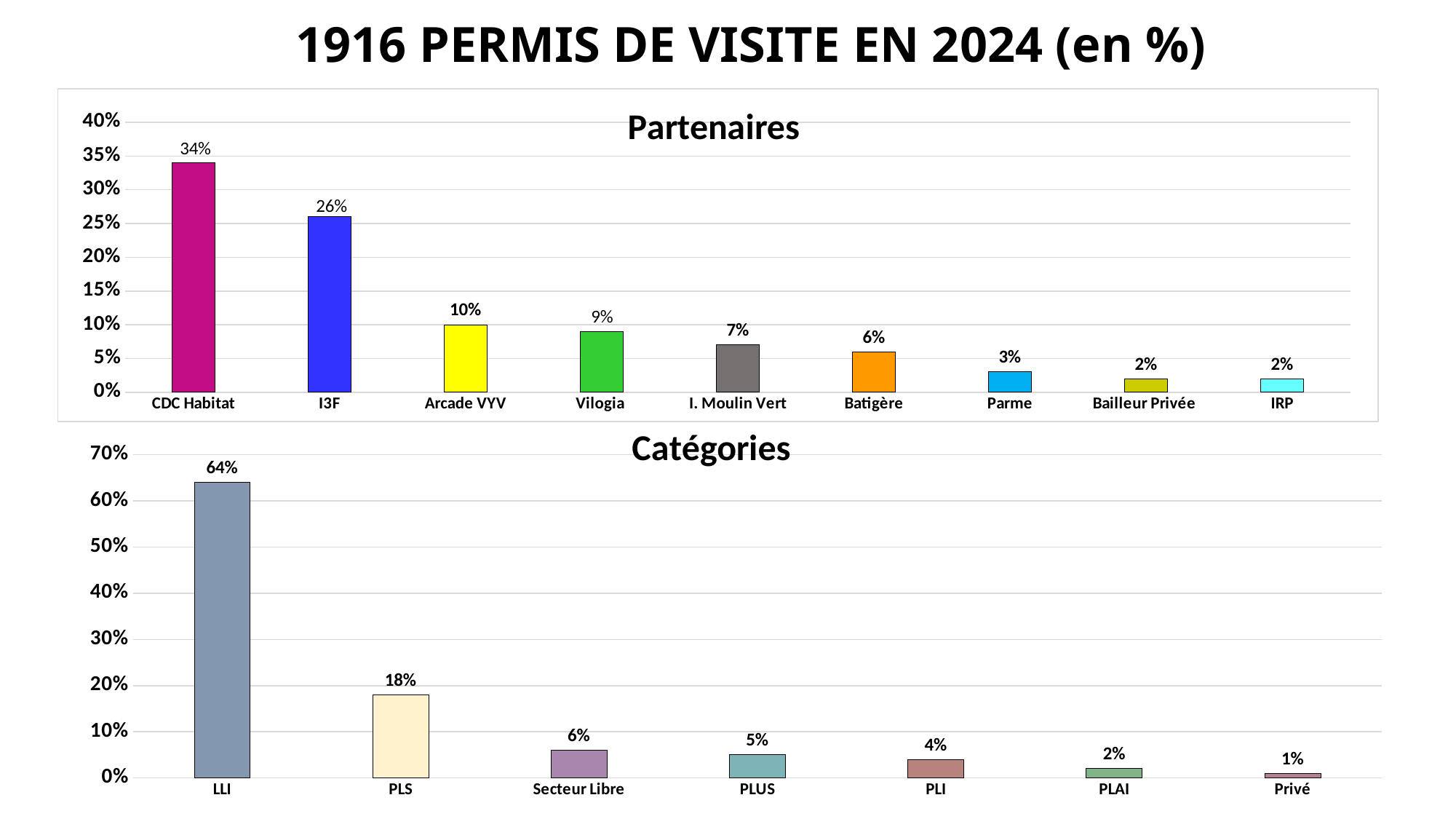
In the Partenaires chart, what is the difference between CDC Habitat and I3F? 8% In the Catégories chart, what is the value for PLS? 18% In the Partenaires chart, which partner has the highest value? CDC Habitat What is the main title of the slide? 1916 PERMIS DE VISITE EN 2024 (en %) In the Catégories chart, which category has the lowest value? Privé What kind of chart is the Catégories chart? Bar chart In the Partenaires chart, how many partners are shown? 9 In the Partenaires chart, what is the value for Vilogia? 9% In the Catégories chart, how many categories are shown? 7 In the Partenaires chart, what is the value for CDC Habitat? 34% In the Partenaires chart, which is larger, Arcade VYV or Batigère? Arcade VYV In the Catégories chart, what is the difference between LLI and PLS? 46%